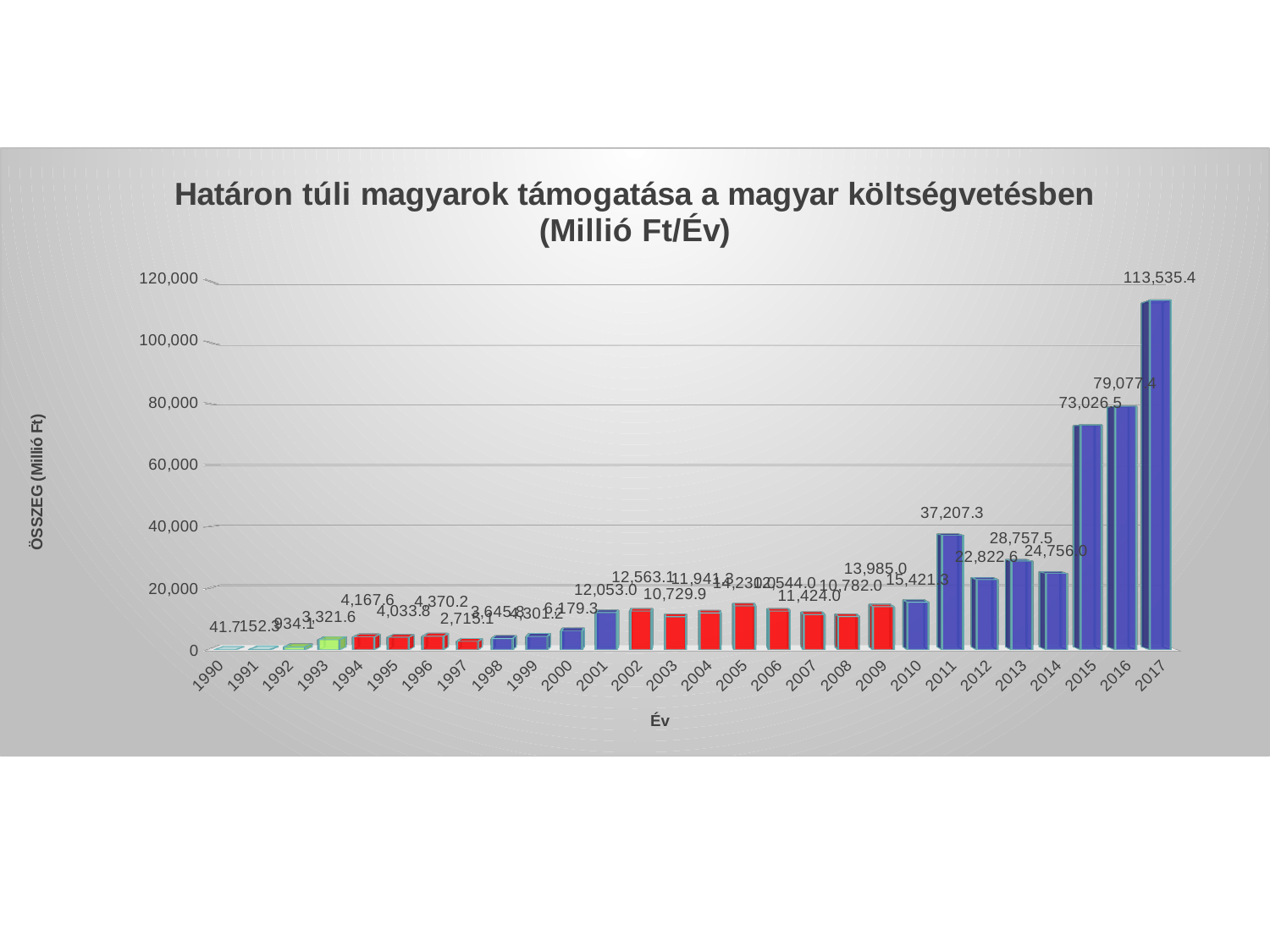
What is the value for 2017? 113,535.4 Which is larger, the value for 2013 or the value for 2012? 2013 What is the difference between the values for 2013 and 2012? 5,934.9 Which year has the highest value? 2017 What is the value for 2015? 73,026.5 How many years are shown on the x axis? 28 What is the difference between the values for 2017 and 2016? 34,458.0 What is the value for 2011? 37,207.3 What kind of chart is this? bar chart Do the values generally rise or fall from 1990 to 2017? rise Which year has the lowest value? 1990 Is the value for 2015 greater or less than 60,000? greater